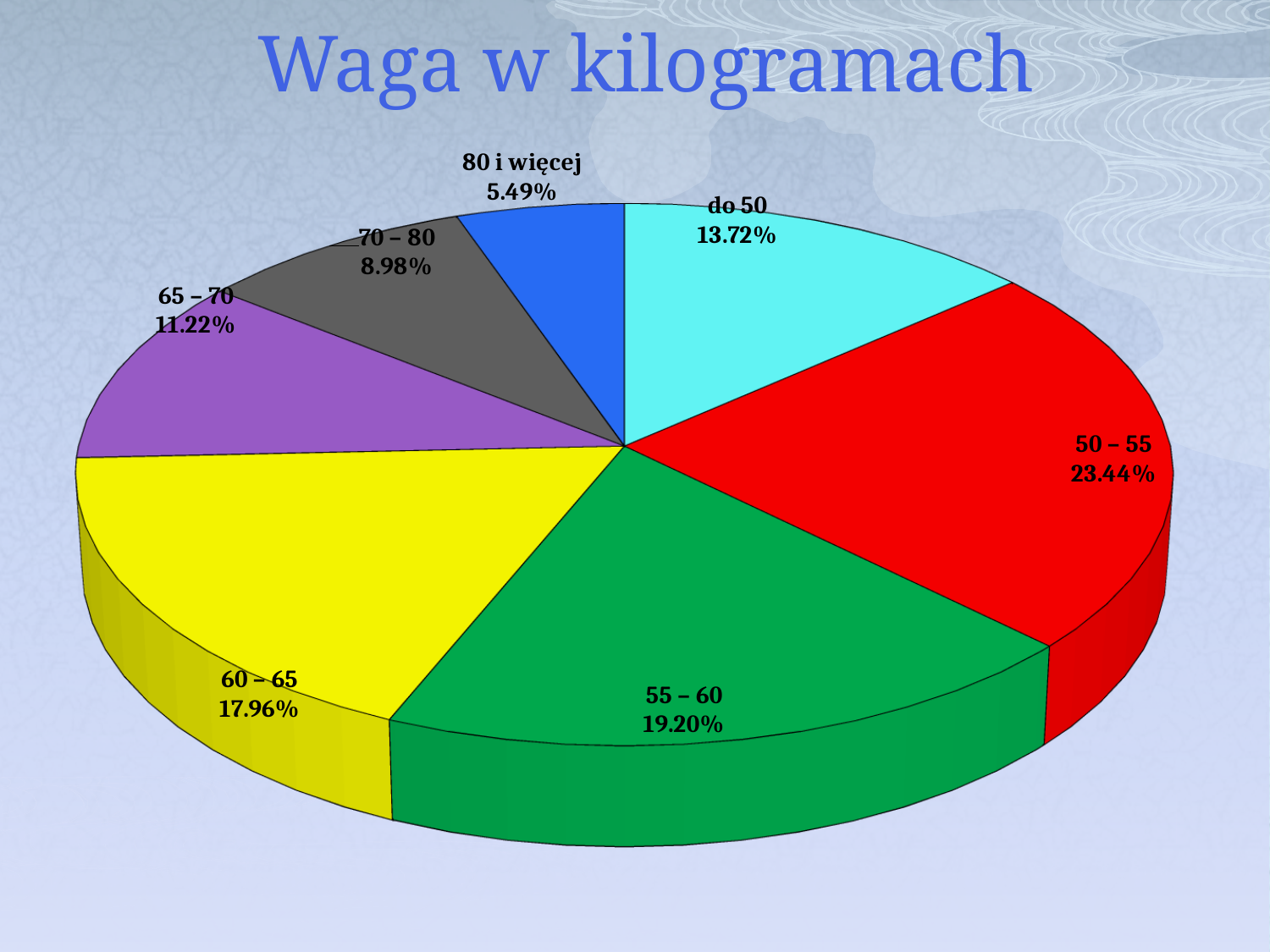
What is the value shown for the "80 i więcej" slice? 5.49% Which is larger, the "55 – 60" slice or the "60 – 65" slice? 55 – 60 Which category has the largest slice of the pie? 50 – 55 What is the title of the chart? Waga w kilogramach What kind of chart is shown on the slide? pie chart How many slices does the pie chart have? 7 Which category has the smallest slice of the pie? 80 i więcej What is the value shown for the "do 50" slice? 13.72% What colour is the "70 – 80" slice? grey What share of the pie does the "50 – 55" slice have? 23.44% What is the value shown for the "65 – 70" slice? 11.22% What is the difference between the "50 – 55" share and the "55 – 60" share? 4.24%